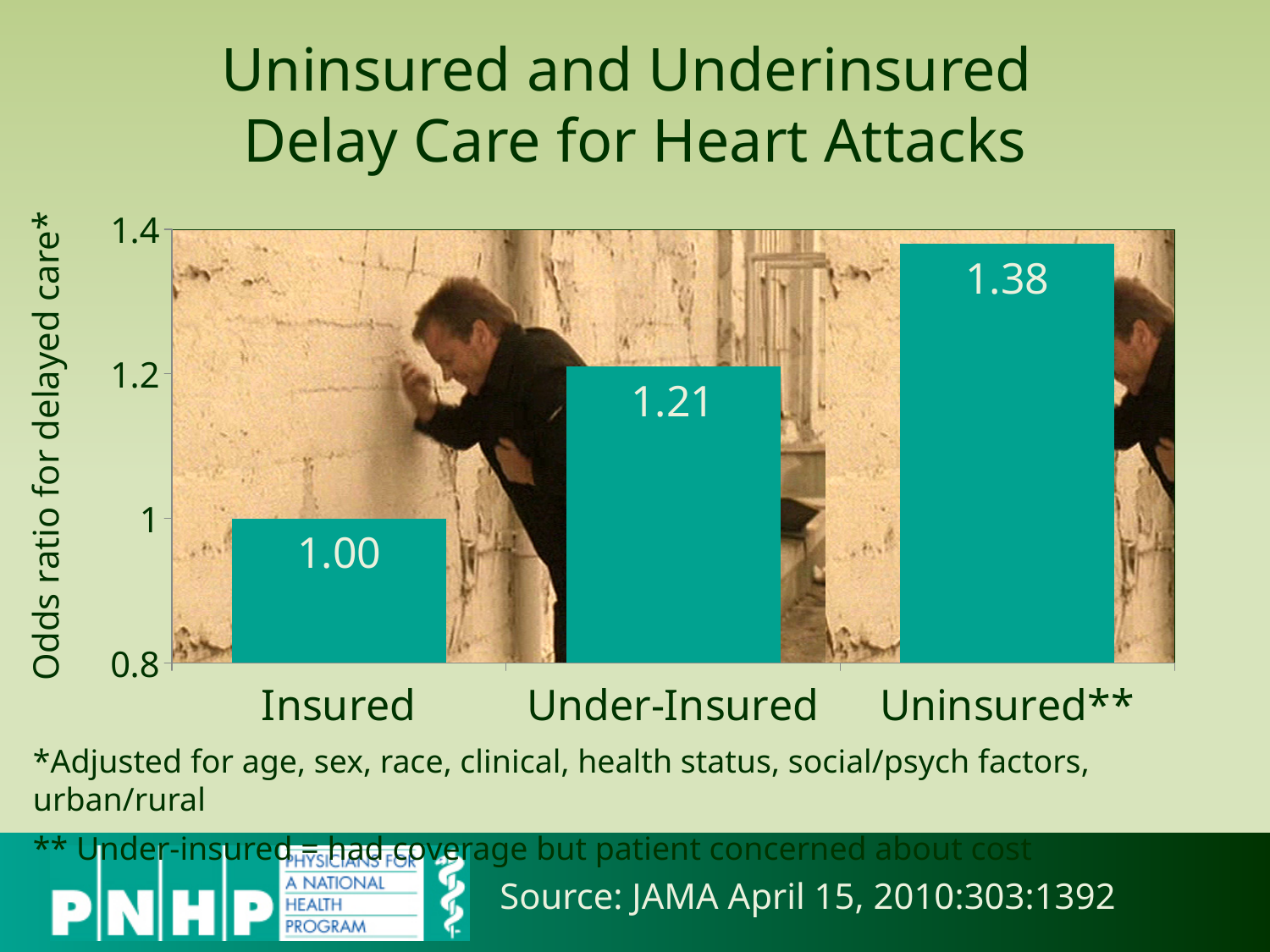
What is the difference between the odds ratios for the Uninsured** and Under-Insured groups? 0.17 Which group has the lowest odds ratio for delayed care? Insured What is the difference between the odds ratios for the Uninsured** and Insured groups? 0.38 Is the odds ratio for the Under-Insured group greater or less than 1.2? greater What kind of chart is shown on the slide? Bar chart What is the odds ratio for delayed care for the Under-Insured group? 1.21 How many groups are shown on the x axis of the chart? 3 Which group has the highest odds ratio for delayed care? Uninsured** What is the odds ratio for delayed care for the Insured group? 1.00 Do the odds ratios rise or fall moving from Insured to Uninsured** along the x axis? Rise What is the odds ratio for delayed care for the Uninsured** group? 1.38 Which has a larger odds ratio for delayed care, Under-Insured or Insured? Under-Insured